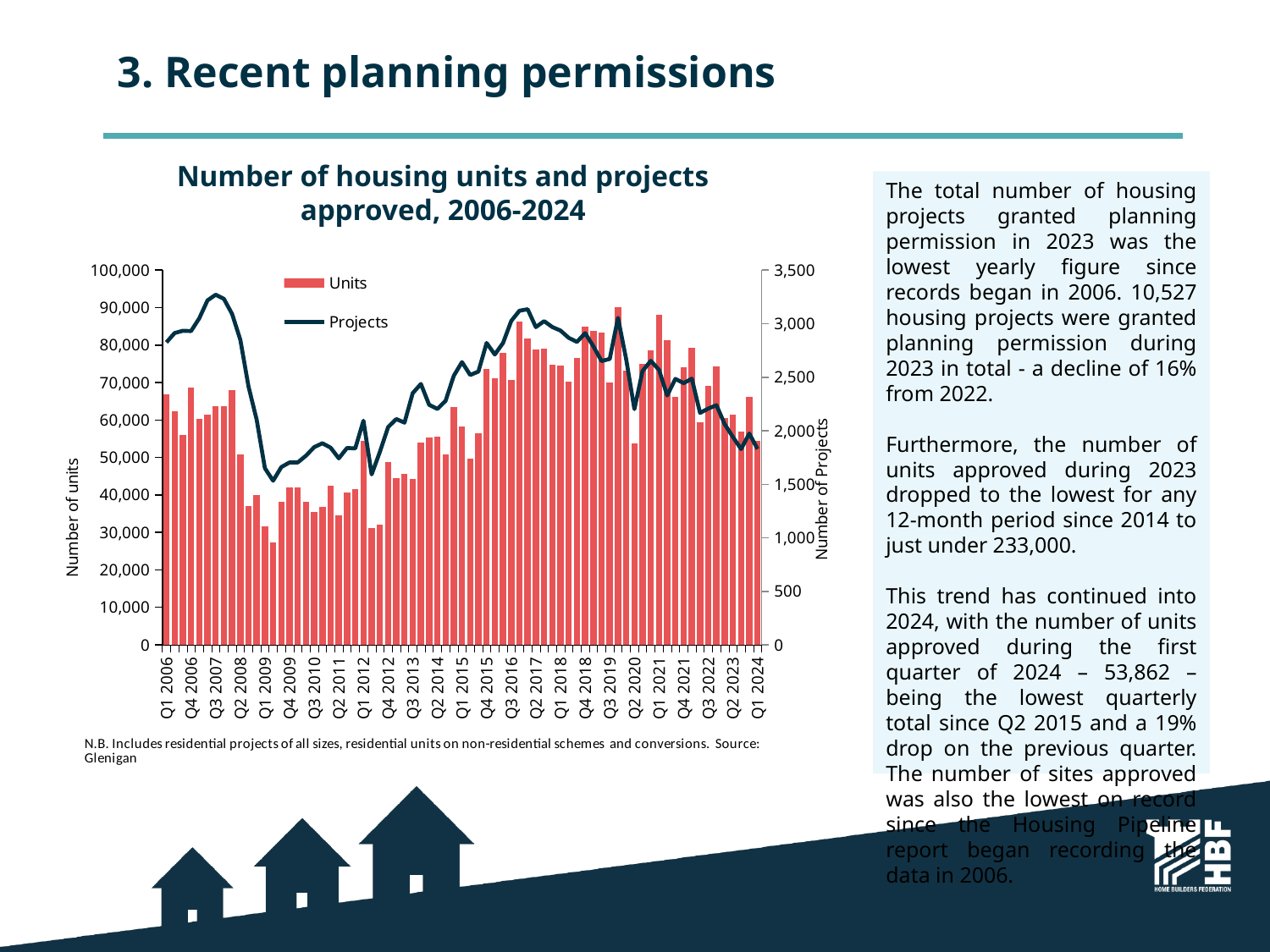
Which labelled quarter has the lowest number of units approved? Q1 2009 Is the number of units approved in Q1 2009 greater or less than 40,000? less What is the title of the right-hand vertical axis? Number of Projects Is the number of projects approved in Q1 2024 greater or less than 2,000? less Is the number of projects approved in Q3 2007 greater or less than 3,000? greater How many series does the chart legend list? 2 Do the number of units approved rise or fall from Q1 2006 to Q1 2009? fall Which series is shown as a line rather than bars? Projects Which is larger, the number of units approved in Q1 2006 or in Q1 2009? Q1 2006 Does the number of projects approved rise or fall from Q1 2009 to Q3 2016? rise What kind of chart is used to show the number of housing units and projects approved, 2006-2024? A bar chart combined with a line chart